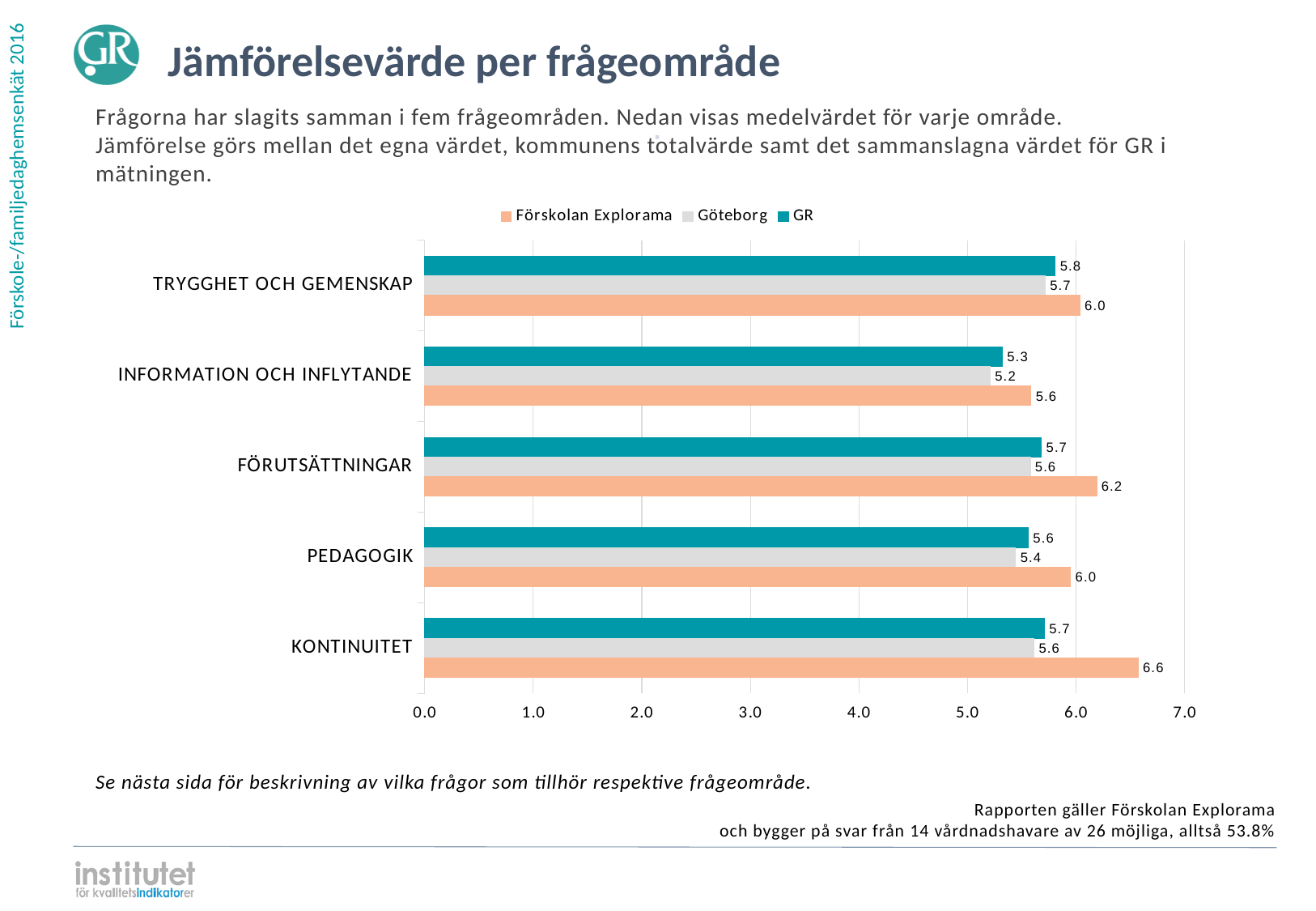
What is the value for Göteborg in the PEDAGOGIK category? 5.4 In which category does Göteborg have its lowest value? INFORMATION OCH INFLYTANDE Which is larger for TRYGGHET OCH GEMENSKAP: the GR value or the Förskolan Explorama value? Förskolan Explorama How many categories (frågeområden) are shown on the chart? 5 What kind of chart is shown on the slide? bar chart In which category does Förskolan Explorama have its highest value? KONTINUITET What is the value for GR in the INFORMATION OCH INFLYTANDE category? 5.3 What is the value for Förskolan Explorama in the KONTINUITET category? 6.6 How many series does the legend list? 3 Is the Förskolan Explorama value for KONTINUITET greater or less than 6.0? greater What is the difference between the Förskolan Explorama value and the Göteborg value for FÖRUTSÄTTNINGAR? 0.6 Which series is shown in orange in the legend? Förskolan Explorama